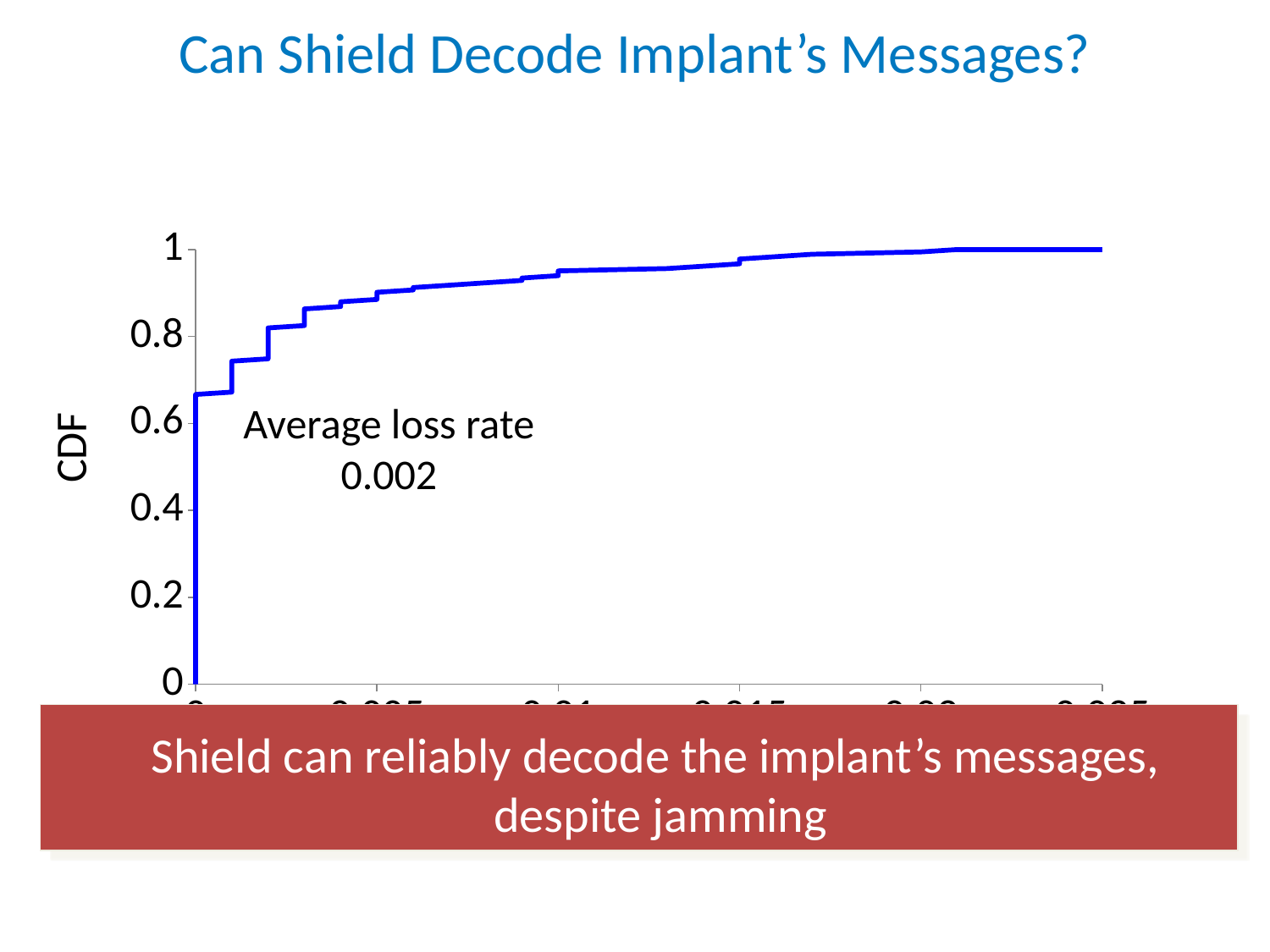
What average loss rate is annotated on the chart? 0.002 Is the CDF value at the first step of the curve (at x = 0) greater or less than 0.8? less Is the CDF value at the x-axis tick 0.01 greater or less than 0.8? greater Does the CDF curve rise or fall as the x axis increases? rise What CDF value does the curve reach at its right end? 1 What is the title of the slide containing the chart? Can Shield Decode Implant's Messages? Is the CDF value at the first step of the curve (at x = 0) greater or less than 0.6? greater How many lines are plotted on the chart? 1 What is the label on the y axis of the chart? CDF What kind of chart is shown on the slide? line chart